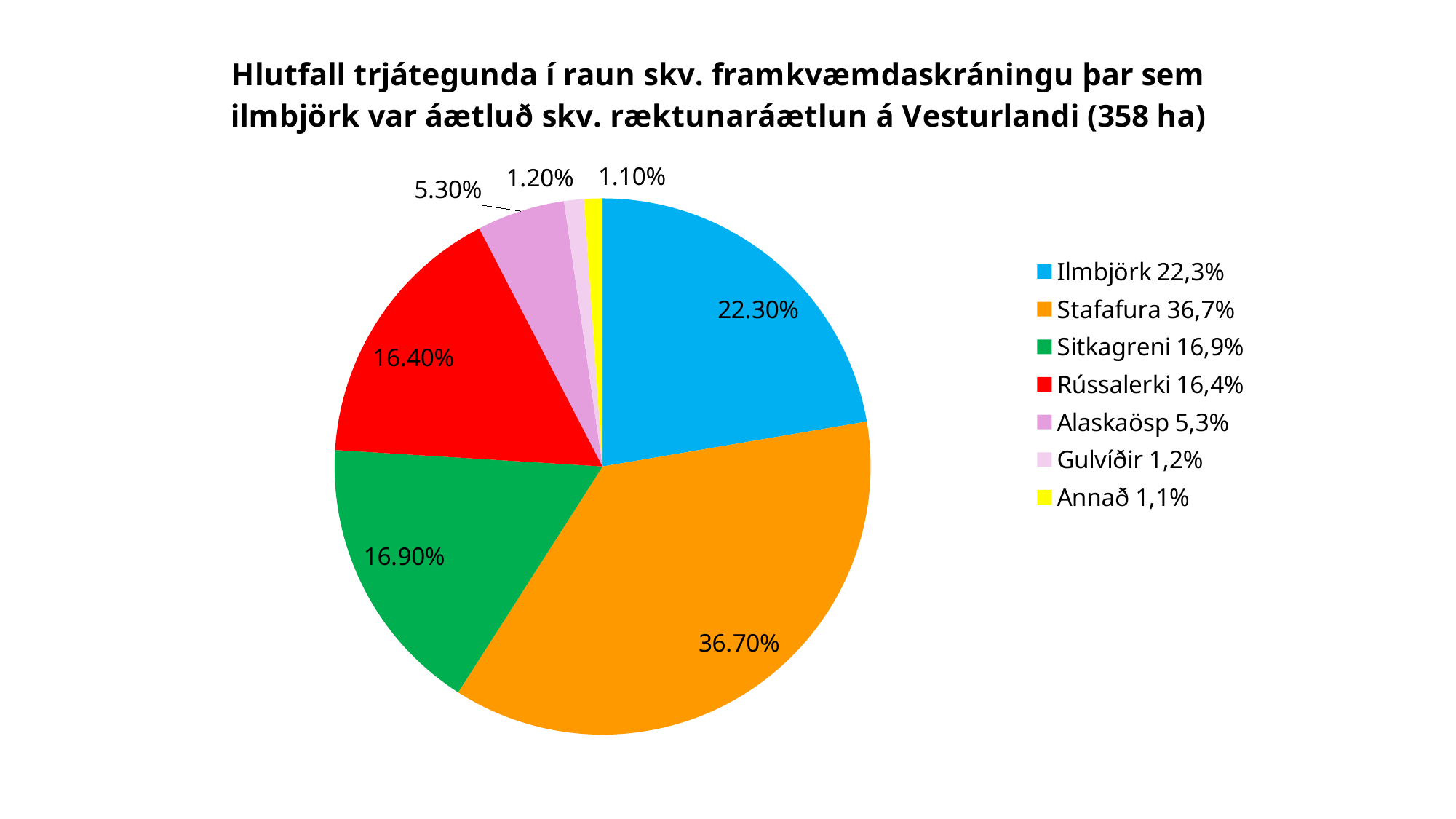
What is the combined share of Gulvíðir and Annað? 2.30% How many slices does the pie chart have? 7 What colour is the Rússalerki slice? red What share of the pie does Stafafura have? 36.70% Which has the larger share, Sitkagreni or Rússalerki? Sitkagreni What share of the pie does Rússalerki have? 16.40% Which category has the smallest slice of the pie? Annað What share of the pie does Alaskaösp have? 5.30% What type of chart is shown on the slide? pie chart What share of the pie does Ilmbjörk have? 22.30% Which tree species has the largest slice of the pie? Stafafura What is the difference between the shares of Stafafura and Ilmbjörk? 14.40%